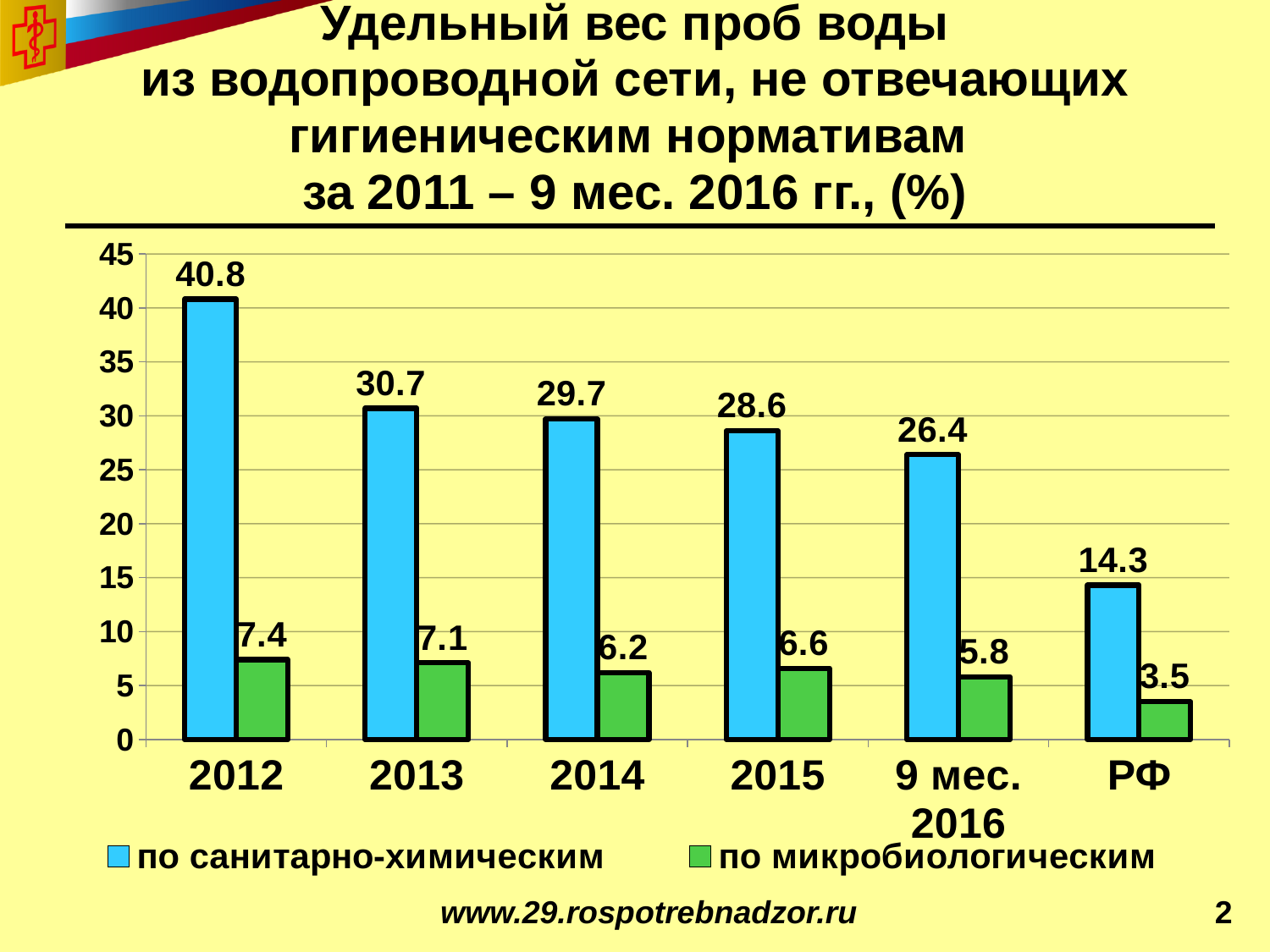
What is the value for 'по санитарно-химическим' for РФ? 14.3 Which is larger: the 'по микробиологическим' value for 2014 or for 2015? 2015 What is the value for 'по микробиологическим' for 9 мес. 2016? 5.8 What kind of chart is shown on the slide? bar chart Which category has the lowest value for 'по микробиологическим'? РФ Do the 'по санитарно-химическим' values rise or fall from 2012 to 9 мес. 2016? fall Is the value for 'по санитарно-химическим' in 2015 greater or less than 25? greater What is the value for 'по санитарно-химическим' in 2012? 40.8 What is the difference between the 'по санитарно-химическим' values for 2012 and 2013? 10.1 How many series does the legend list? 2 Which category has the highest value for 'по санитарно-химическим'? 2012 How many categories are shown on the x axis? 6